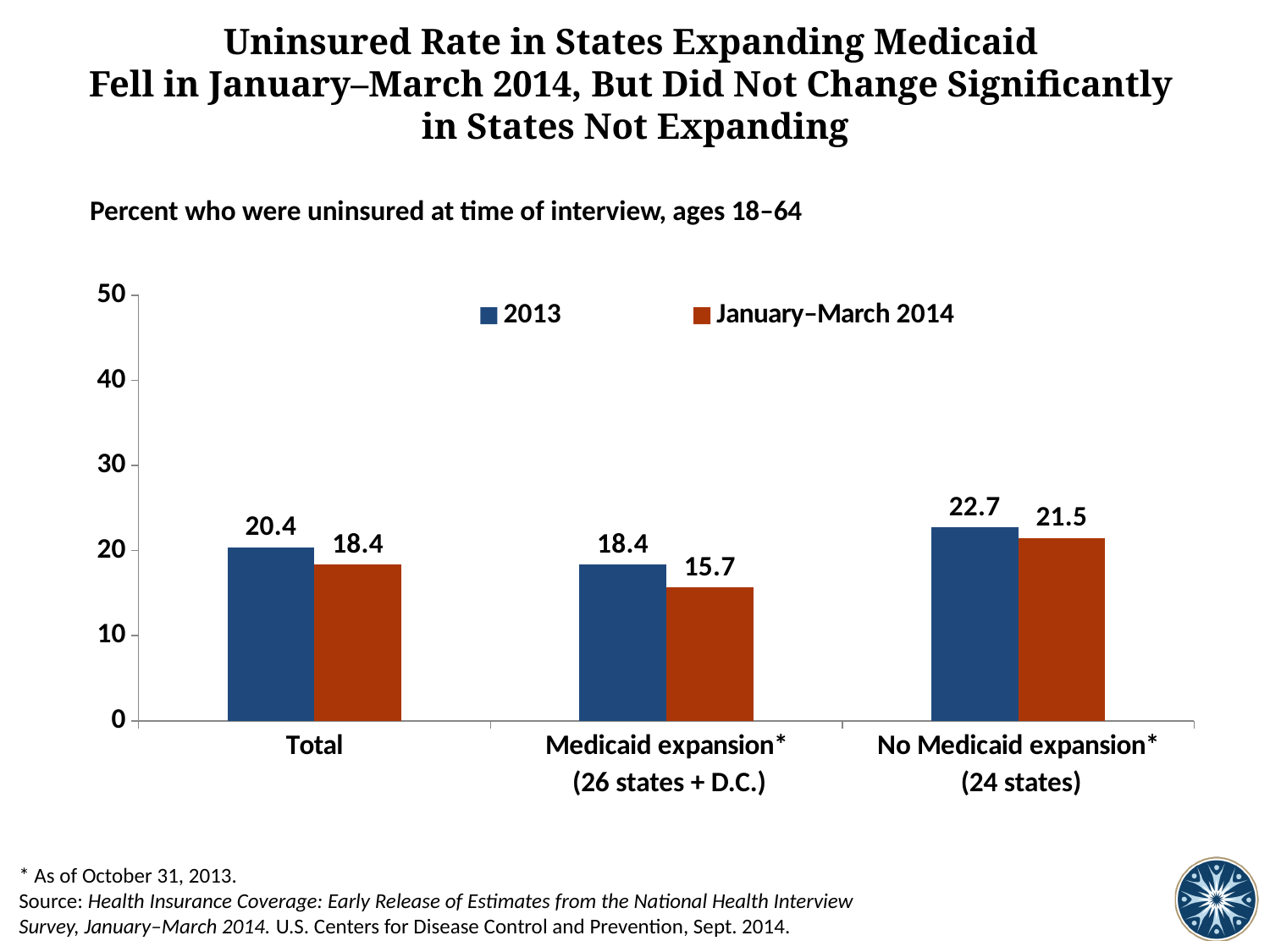
Which category has the lowest 2013 uninsured rate? Medicaid expansion What is the difference between the 2013 and January–March 2014 uninsured rates for the Total category? 2.0 What is the 2013 uninsured rate for the Total category? 20.4 What type of chart is shown on the slide? bar chart Which category has the highest January–March 2014 uninsured rate? No Medicaid expansion How many series does the legend list? 2 What is the January–March 2014 uninsured rate for No Medicaid expansion states? 21.5 How many categories are shown on the x axis? 3 What is the January–March 2014 uninsured rate for Medicaid expansion states? 15.7 By how much did the uninsured rate in Medicaid expansion states fall from 2013 to January–March 2014? 2.7 What is the 2013 uninsured rate for No Medicaid expansion states? 22.7 Is the 2013 uninsured rate for Medicaid expansion states higher or lower than the 2013 rate for No Medicaid expansion states? lower